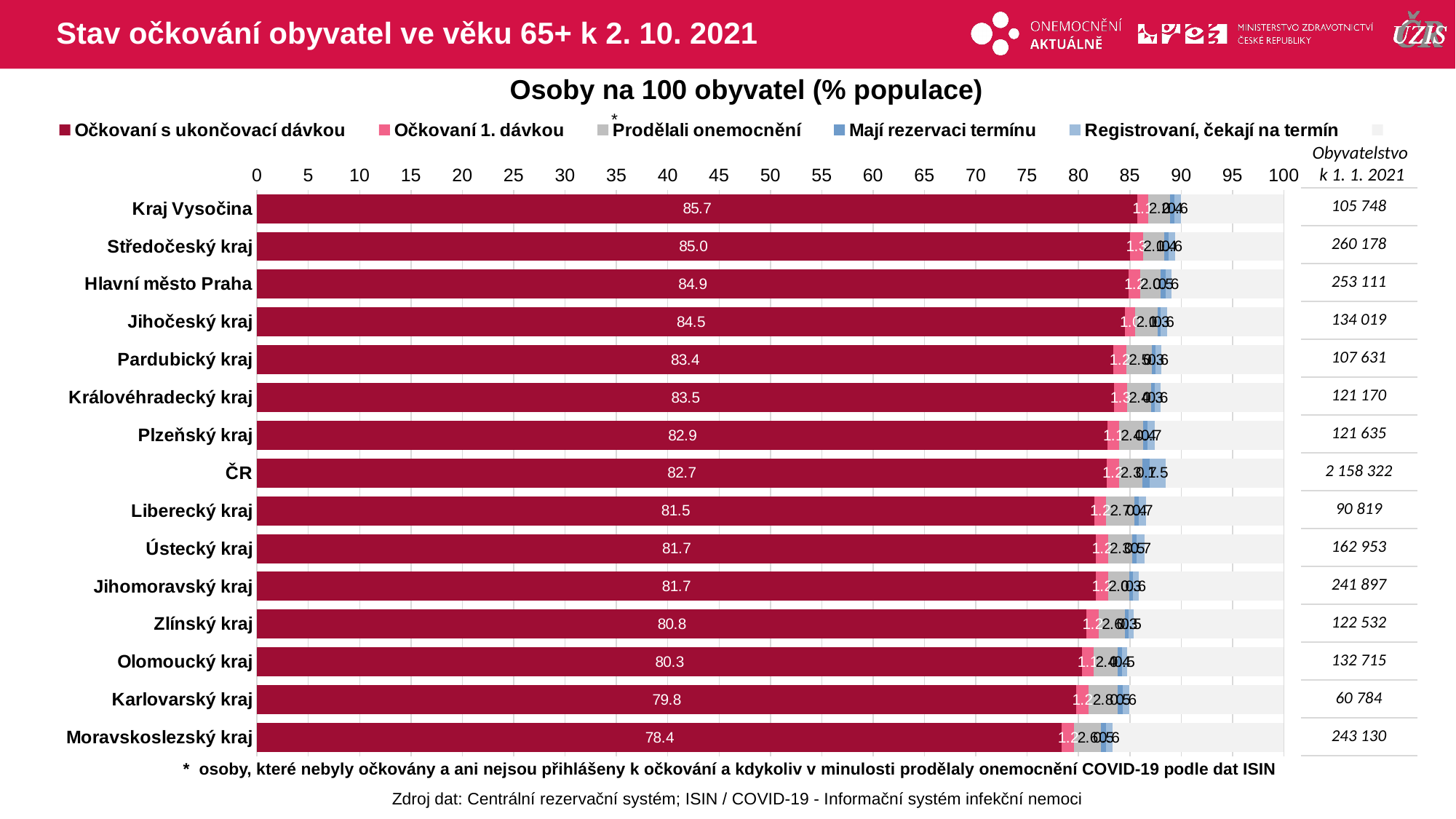
Which has a higher 'Očkovaní s ukončovací dávkou' value, Středočeský kraj or Karlovarský kraj? Středočeský kraj What is the value of 'Očkovaní s ukončovací dávkou' for Moravskoslezský kraj? 78.4 Which category has the lowest value for 'Očkovaní s ukončovací dávkou'? Moravskoslezský kraj What is the value of 'Očkovaní s ukončovací dávkou' for ČR? 82.7 What is the difference between the 'Očkovaní s ukončovací dávkou' values for Kraj Vysočina and Moravskoslezský kraj? 7.3 What is the title of the chart? Osoby na 100 obyvatel (% populace) How many categories (rows) are shown in the chart? 15 What kind of chart is shown on the slide? Stacked horizontal bar chart Which category has the highest value for 'Očkovaní s ukončovací dávkou'? Kraj Vysočina Is the 'Očkovaní s ukončovací dávkou' value for Zlínský kraj greater or less than 85? less What is the value of 'Očkovaní s ukončovací dávkou' for Kraj Vysočina? 85.7 What is the value of 'Očkovaní s ukončovací dávkou' for Olomoucký kraj? 80.3